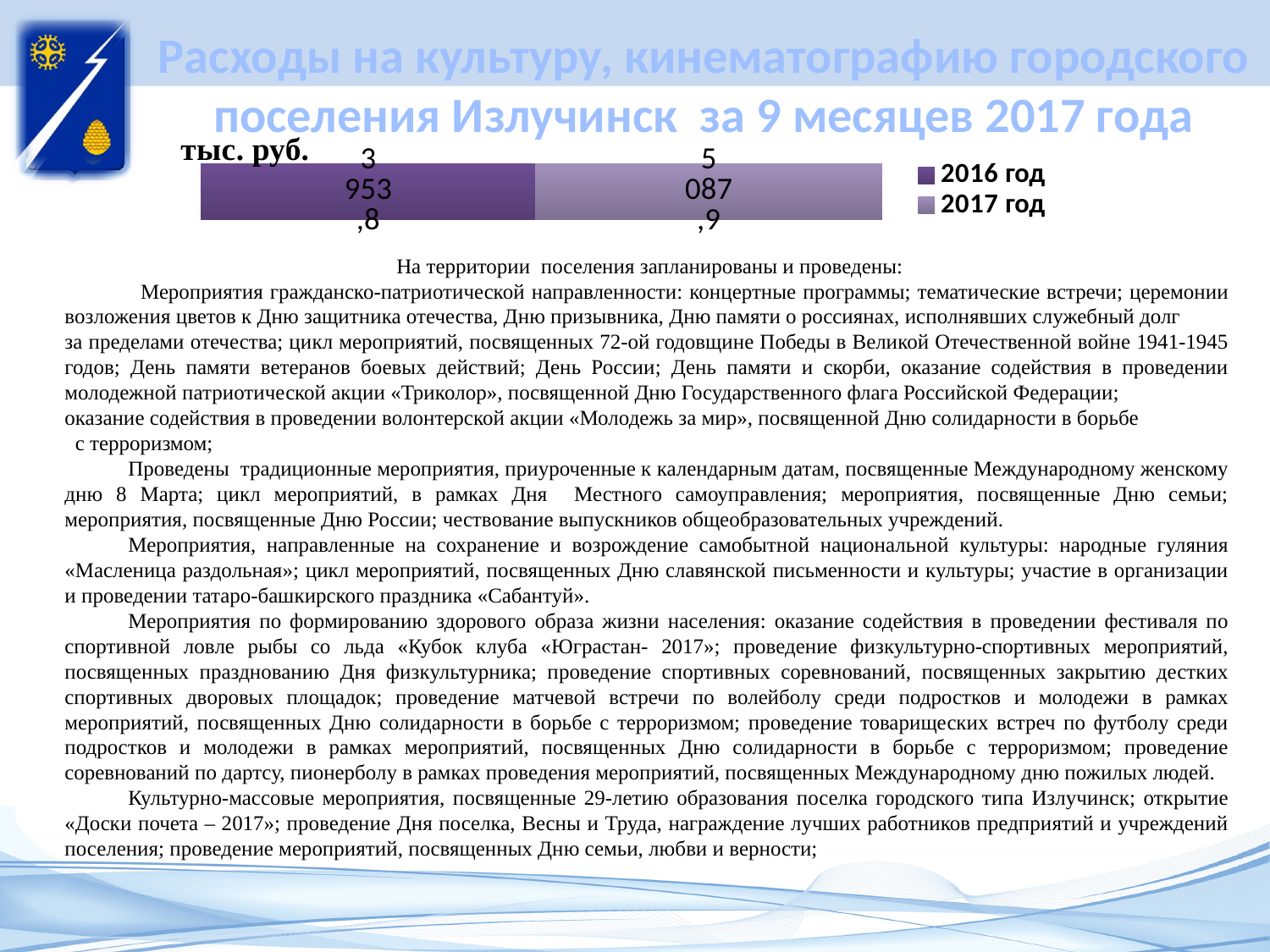
What is the value shown for 2017 год on the chart? 5 087,9 What is the total of the two segments in the stacked bar? 9 041,7 How many series does the legend list? 2 What is the difference between the 2017 год and 2016 год values? 1 134,1 Did the expenditure rise or fall from 2016 год to 2017 год? Rise Which series has the higher value, 2016 год or 2017 год? 2017 год Which year has the smallest value on the chart? 2016 год What is the value shown for 2016 год on the chart? 3 953,8 Which year has the largest value on the chart? 2017 год Which legend entry is shown in the darker purple colour? 2016 год What unit label is shown next to the chart? тыс. руб. What kind of chart is shown on the slide? Bar chart